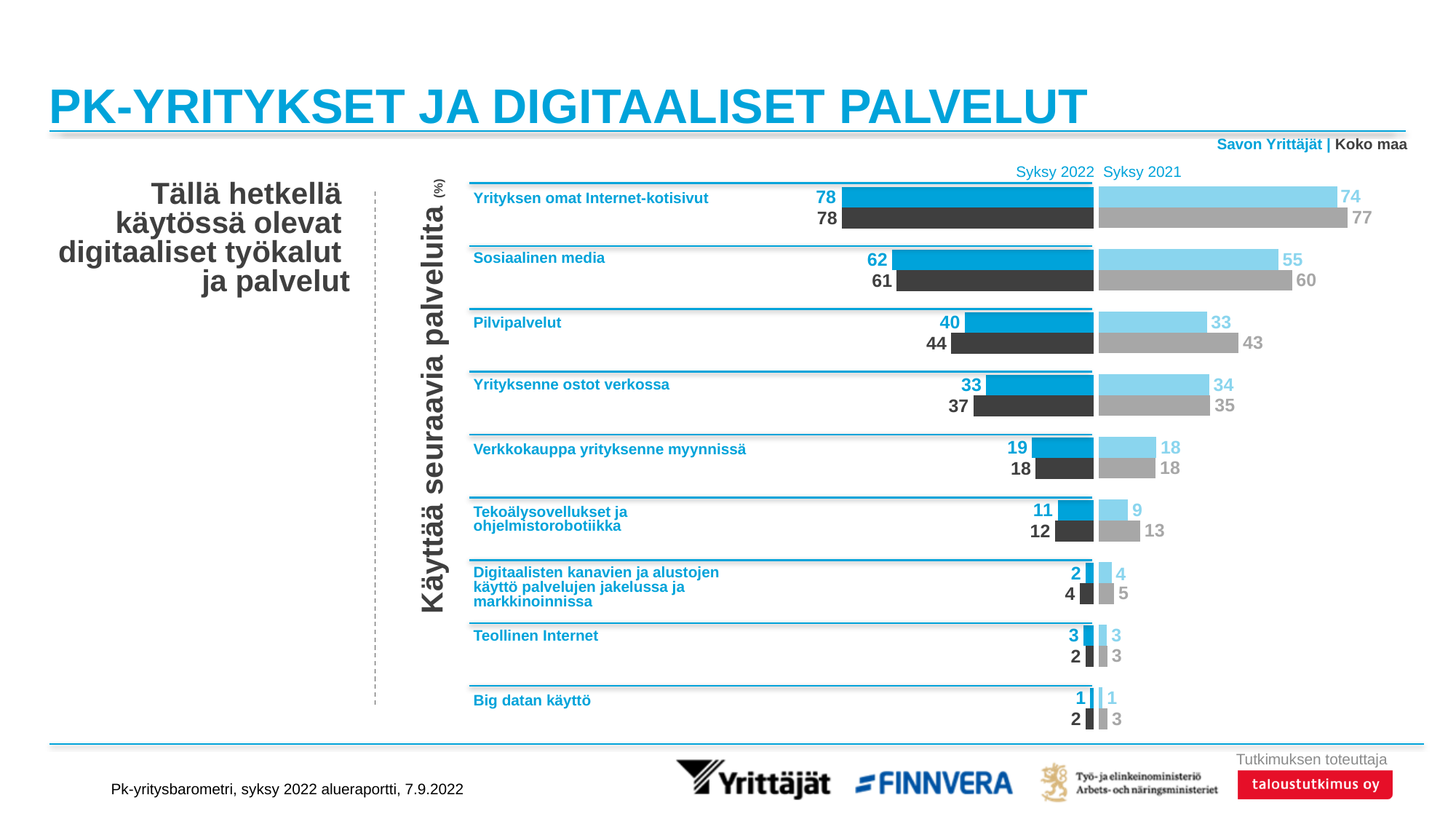
What is the Syksy 2022 value for Savon Yrittäjät for Yrityksen omat Internet-kotisivut? 78 For Pilvipalvelut in Syksy 2021, which is larger: Savon Yrittäjät or Koko maa? Koko maa Which category has the lowest Syksy 2022 value for Savon Yrittäjät? Big datan käyttö What is the difference between the Syksy 2022 and Syksy 2021 values for Savon Yrittäjät for Sosiaalinen media? 7 What is the difference between the Koko maa and Savon Yrittäjät Syksy 2022 values for Yrityksenne ostot verkossa? 4 What is the Syksy 2021 value for Savon Yrittäjät for Tekoälysovellukset ja ohjelmistorobotiikka? 9 What is the Syksy 2022 value for Koko maa for Pilvipalvelut? 44 Which category has the highest Syksy 2022 value for Savon Yrittäjät? Yrityksen omat Internet-kotisivut What is the Syksy 2021 value for Koko maa for Sosiaalinen media? 60 How many categories (digital tools and services) are listed in the chart? 9 What type of chart is shown on the slide? Bar chart Which two survey periods does the chart compare? Syksy 2022 and Syksy 2021